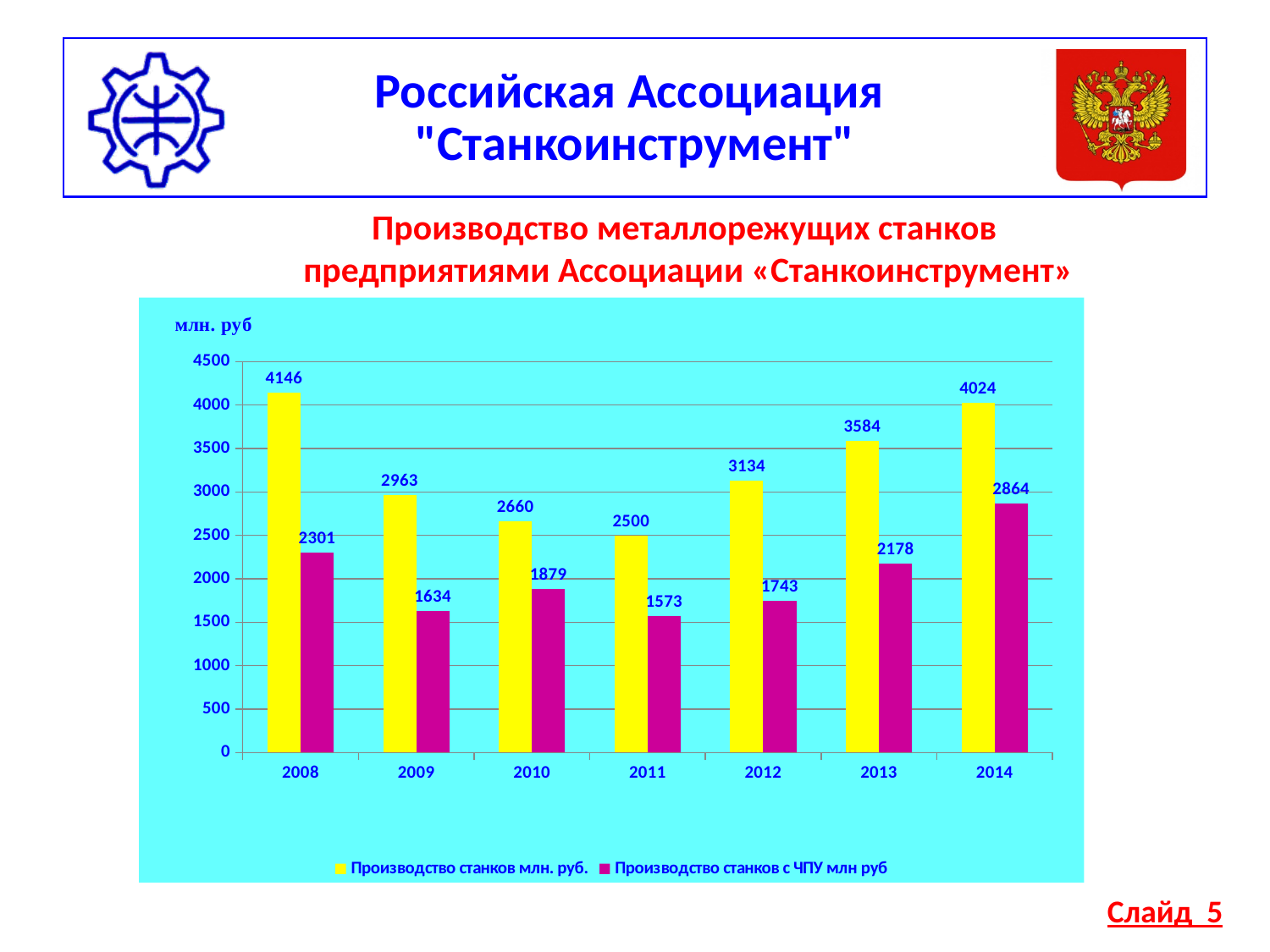
Which year has the lowest value for 'Производство станков с ЧПУ млн руб'? 2011 Which year has the highest value for 'Производство станков млн. руб.'? 2008 How many series does the legend list? 2 What is the value of 'Производство станков с ЧПУ млн руб' for 2013? 2178 What kind of chart is shown on the slide? bar chart How many years are shown on the x axis? 7 What is the value of 'Производство станков с ЧПУ млн руб' for 2011? 1573 Is the value for 'Производство станков с ЧПУ млн руб' in 2010 greater or less than 2000? less Which is larger: 'Производство станков млн. руб.' in 2012 or in 2013? 2013 What is the difference between 'Производство станков млн. руб.' and 'Производство станков с ЧПУ млн руб' in 2014? 1160 What colour are the bars for 'Производство станков с ЧПУ млн руб'? magenta What is the value of 'Производство станков млн. руб.' for 2008? 4146